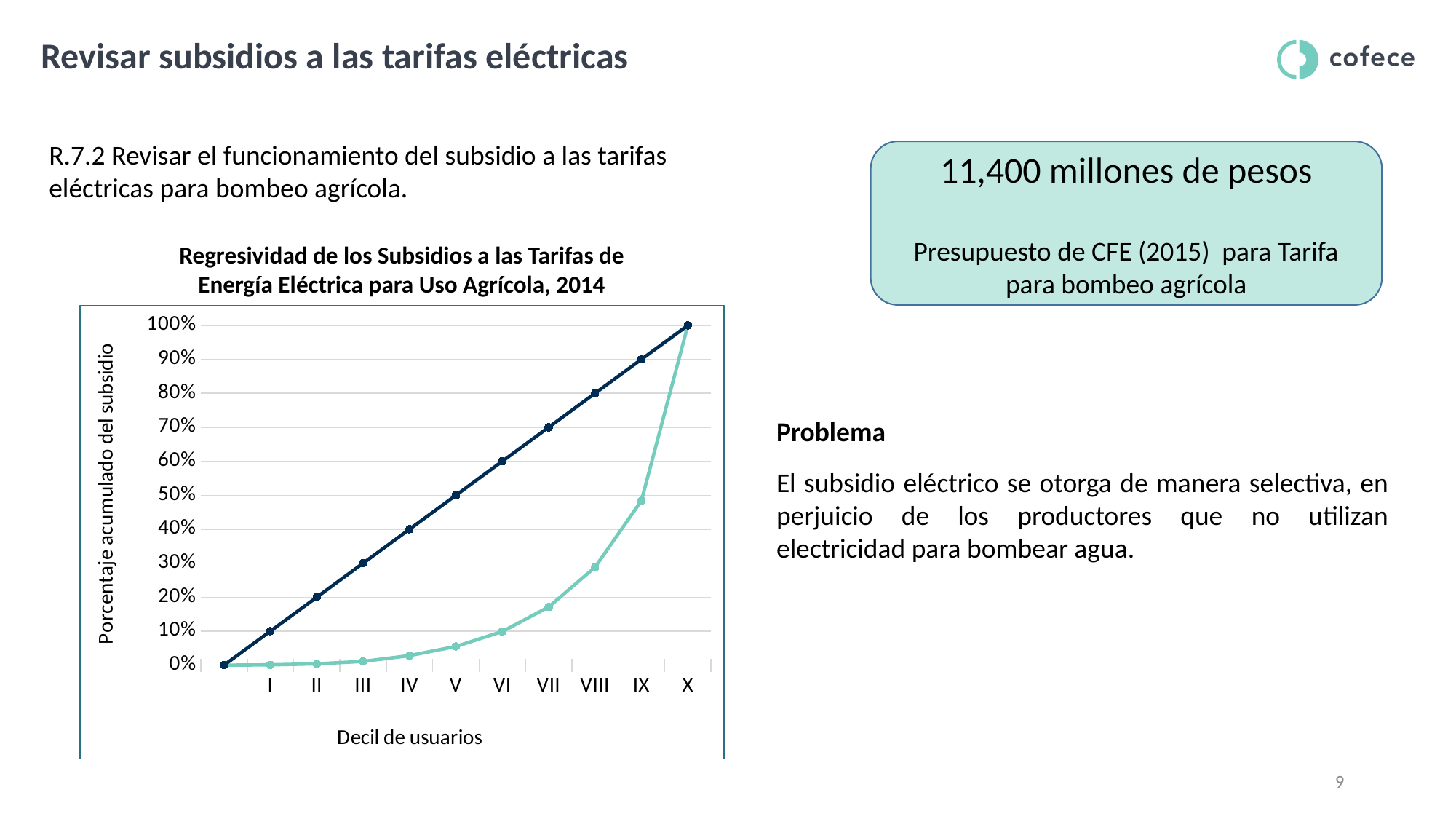
Do the values of the teal curved line rise or fall from decile I to decile X? rise Is the value of the teal curved line at decile VIII greater or less than 20%? greater What value does the dark straight line reach at decile II? 20% What value do both lines reach at decile X? 100% What value does the dark straight line reach at decile V? 50% How many deciles are labelled on the x axis of the chart? 10 What is the label of the y axis of the chart? Porcentaje acumulado del subsidio What is the title of the chart? Regresividad de los Subsidios a las Tarifas de Energía Eléctrica para Uso Agrícola, 2014 Is the value of the teal curved line at decile IX greater or less than 50%? less Is the value of the teal curved line at decile V greater or less than 10%? less What kind of chart is shown on the slide? line chart At decile VII, which line is higher, the dark straight line or the teal curved line? the dark straight line